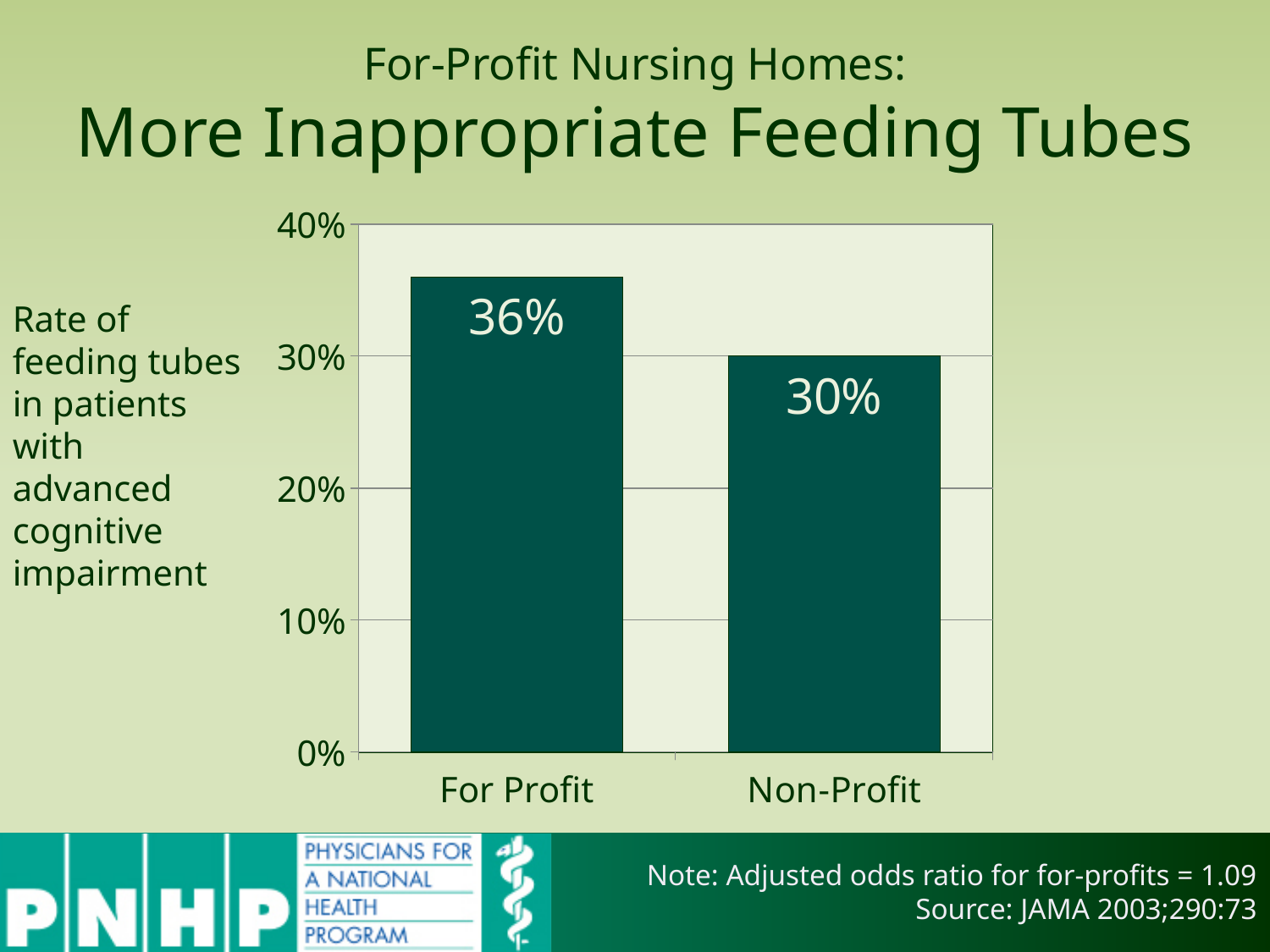
Is the value for Non-Profit greater or less than 20%? greater What is the adjusted odds ratio for for-profits given in the note? 1.09 What kind of chart is shown on the slide? bar chart How many categories are shown on the chart? 2 Which category has the lower rate of feeding tubes? Non-Profit What is the difference in feeding tube rate between For Profit and Non-Profit nursing homes? 6% Is the value for For Profit greater or less than 40%? less What is the maximum value shown on the y axis? 40% What is the rate of feeding tubes for Non-Profit nursing homes? 30% Is the value for For Profit larger or smaller than the value for Non-Profit? larger What is the rate of feeding tubes for For Profit nursing homes? 36% Which category has the higher rate of feeding tubes? For Profit